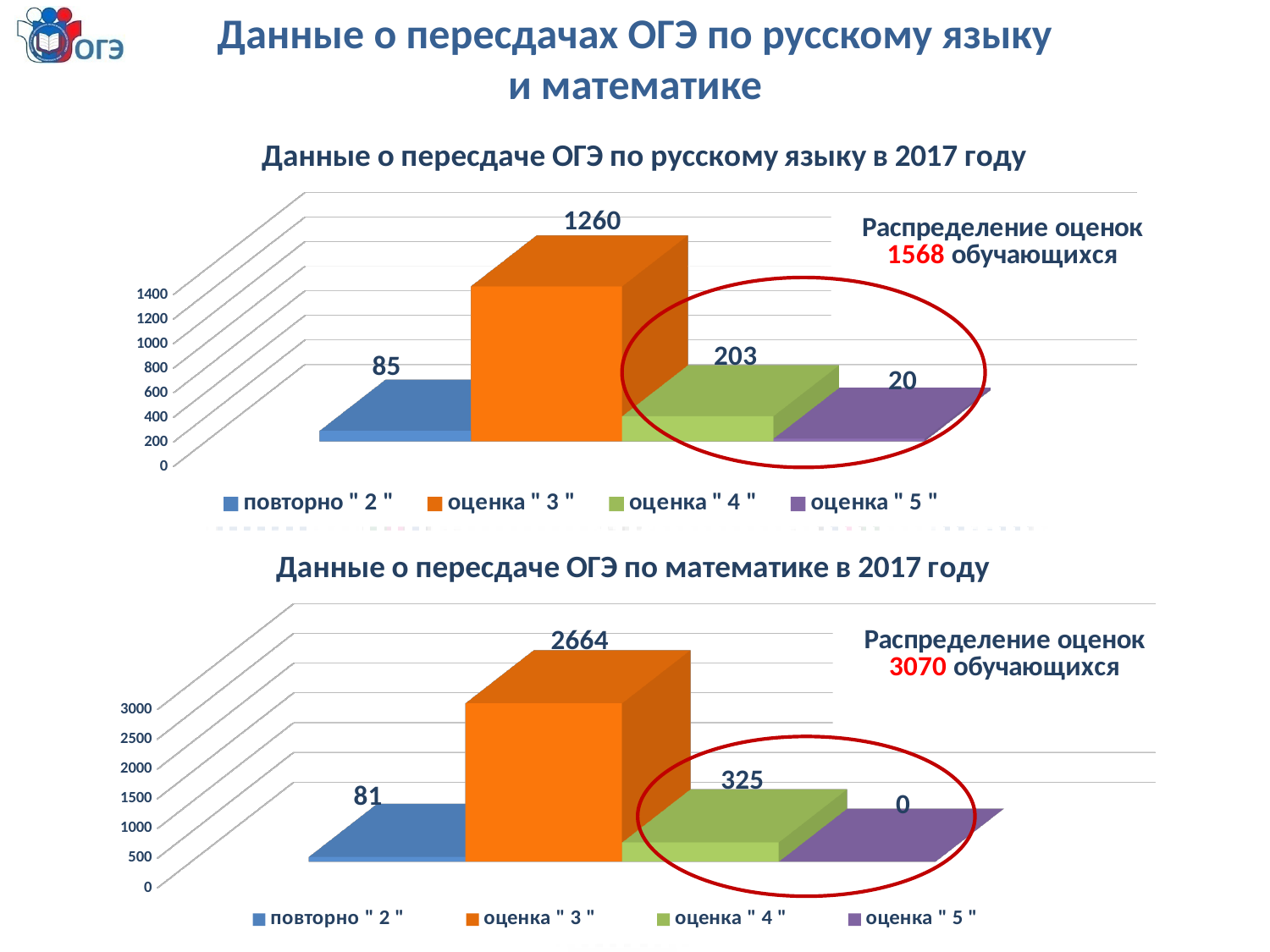
In the chart 'Данные о пересдаче ОГЭ по математике в 2017 году', what is the value for повторно " 2 "? 81 In the chart 'Данные о пересдаче ОГЭ по математике в 2017 году', what colour is the bar for оценка " 3 "? orange In the chart 'Данные о пересдаче ОГЭ по математике в 2017 году', which category has the lowest value? оценка " 5 " In the chart 'Данные о пересдаче ОГЭ по русскому языку в 2017 году', what is the value for оценка " 3 "? 1260 How many series does the legend list in the chart 'Данные о пересдаче ОГЭ по математике в 2017 году'? 4 In the chart 'Данные о пересдаче ОГЭ по математике в 2017 году', what is the difference between the values for оценка " 3 " and оценка " 4 "? 2339 In the chart 'Данные о пересдаче ОГЭ по русскому языку в 2017 году', what is the value for оценка " 5 "? 20 In the chart 'Данные о пересдаче ОГЭ по русскому языку в 2017 году', which category has the highest value? оценка " 3 " In the chart 'Данные о пересдаче ОГЭ по математике в 2017 году', what is the value for оценка " 4 "? 325 What kind of chart is 'Данные о пересдаче ОГЭ по русскому языку в 2017 году'? bar chart In the chart 'Данные о пересдаче ОГЭ по русскому языку в 2017 году', which is larger: the value for повторно " 2 " or the value for оценка " 4 "? оценка " 4 " In the chart 'Данные о пересдаче ОГЭ по русскому языку в 2017 году', what is the difference between the values for оценка " 4 " and повторно " 2 "? 118